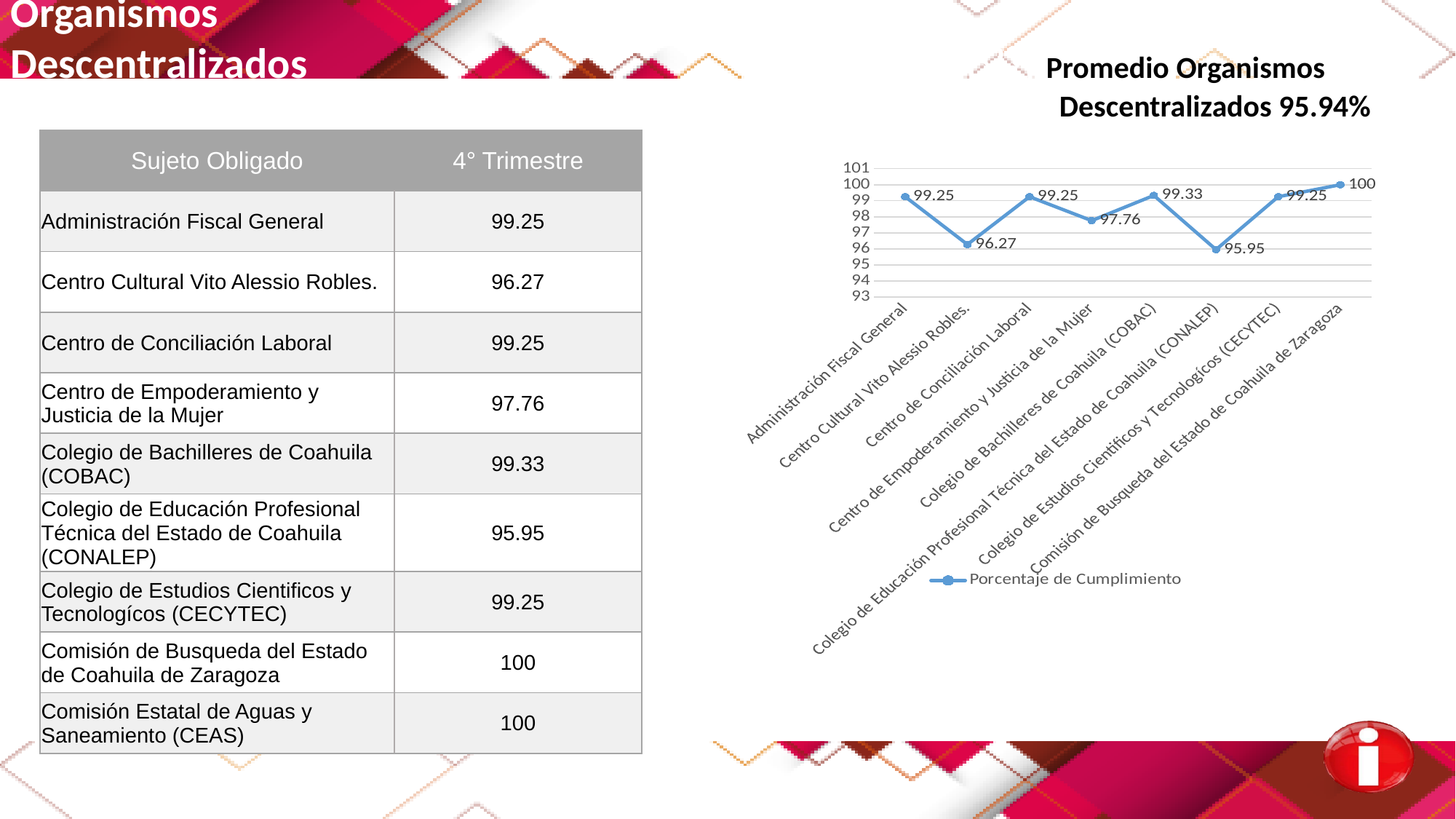
What is the value for Centro Cultural Vito Alessio Robles in the chart? 96.27 What is the value for Colegio de Bachilleres de Coahuila (COBAC) in the chart? 99.33 What is the name of the series shown in the chart legend? Porcentaje de Cumplimiento Which category has the highest value in the chart? Comisión de Busqueda del Estado de Coahuila de Zaragoza How many data points are plotted in the chart? 8 What is the difference between the values for Comisión de Busqueda del Estado de Coahuila de Zaragoza and CONALEP in the chart? 4.05 What type of chart is shown on the slide? line chart How many series does the chart legend list? 1 Is the value for CONALEP in the chart greater or less than 97? less What is the value for Centro de Empoderamiento y Justicia de la Mujer in the chart? 97.76 Which category has the lowest value in the chart? Colegio de Educación Profesional Técnica del Estado de Coahuila (CONALEP) Which is larger in the chart, the value for Centro Cultural Vito Alessio Robles or the value for Centro de Empoderamiento y Justicia de la Mujer? Centro de Empoderamiento y Justicia de la Mujer